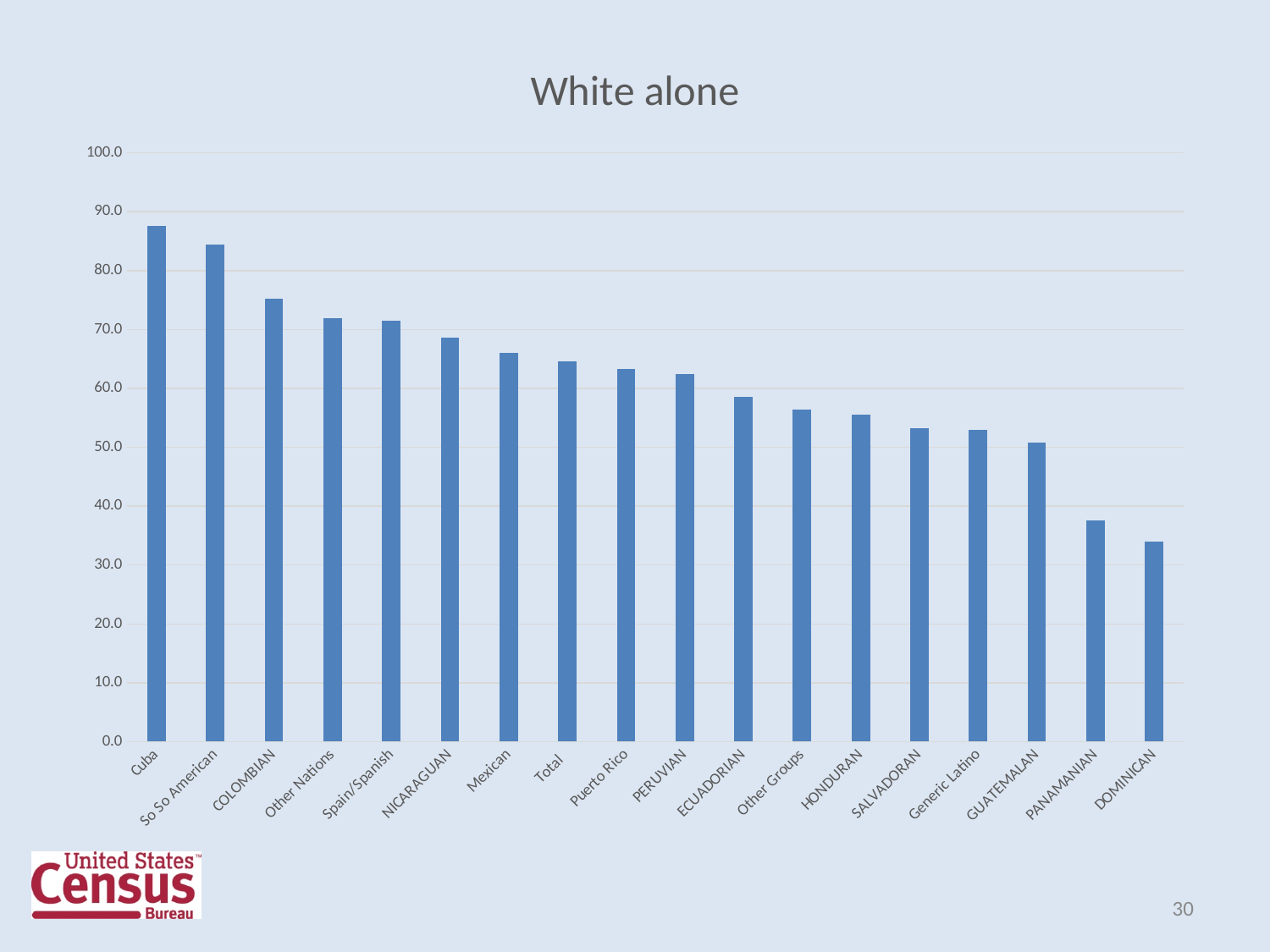
Which category has the lowest value in the chart? DOMINICAN Which has a larger value, COLOMBIAN or PERUVIAN? COLOMBIAN What type of chart is shown on the slide? bar chart Is the value for DOMINICAN greater or less than 40? less What is the title of the chart? White alone Which category has the highest value in the chart? Cuba Is the value for Mexican greater or less than 60? greater How many categories are shown on the x axis of the chart? 18 Do the values generally rise or fall moving from left to right along the x axis? fall Is the value for Cuba greater or less than 80? greater